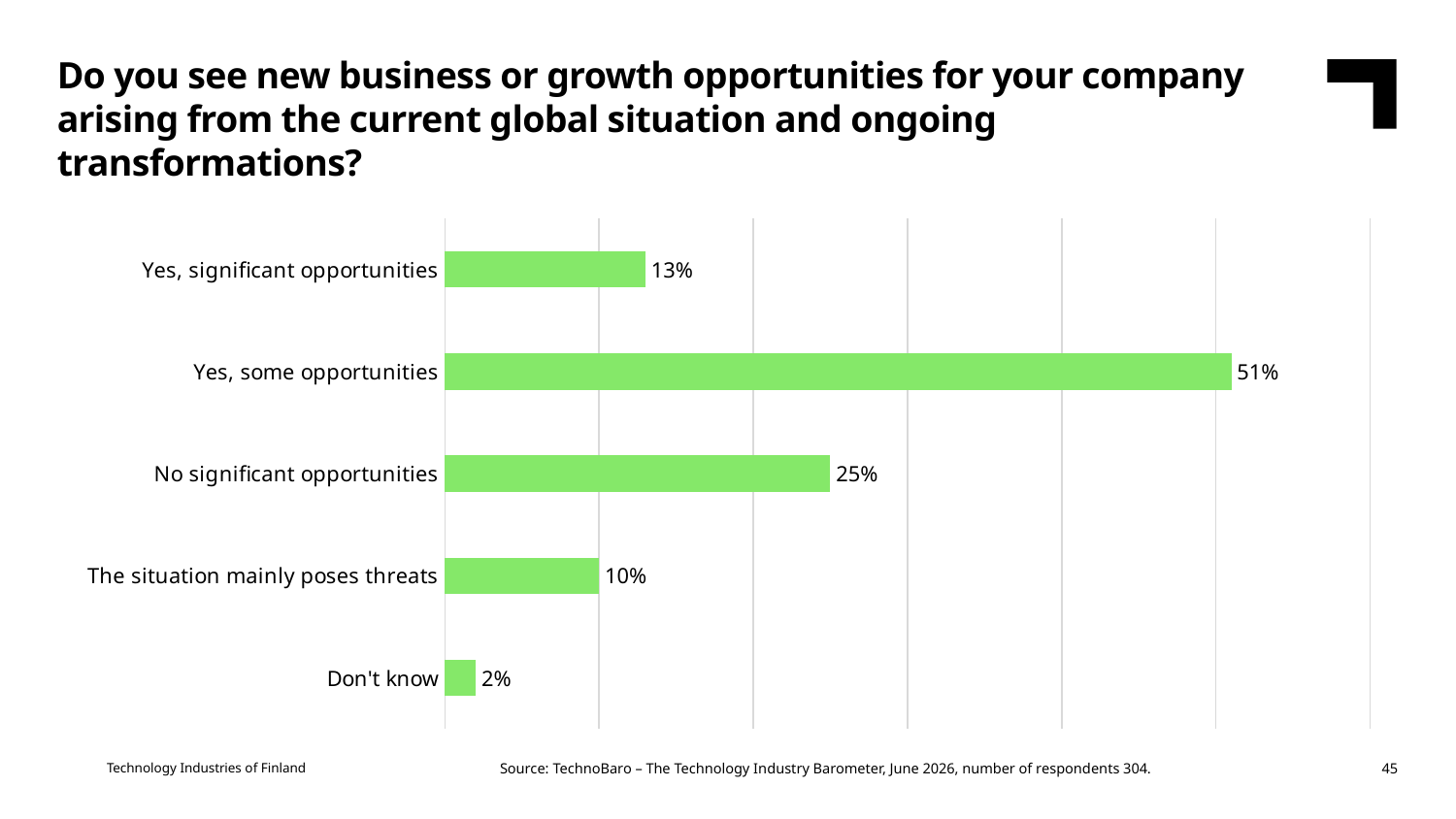
What is the combined value of the two "Yes" responses ("Yes, significant opportunities" and "Yes, some opportunities")? 64% What type of chart is shown on the slide? Bar chart What is the difference between "Yes, significant opportunities" and "The situation mainly poses threats"? 3 percentage points Which is larger: "Yes, significant opportunities" or "No significant opportunities"? No significant opportunities What percentage of respondents answered "Yes, some opportunities"? 51% How many response categories are shown in the chart? 5 What is the difference between "Yes, some opportunities" and "No significant opportunities"? 26 percentage points What is the value for "Don't know"? 2% What is the value for "No significant opportunities"? 25% Which response category has the lowest value? Don't know Which response category has the highest value? Yes, some opportunities What share of respondents said "The situation mainly poses threats"? 10%